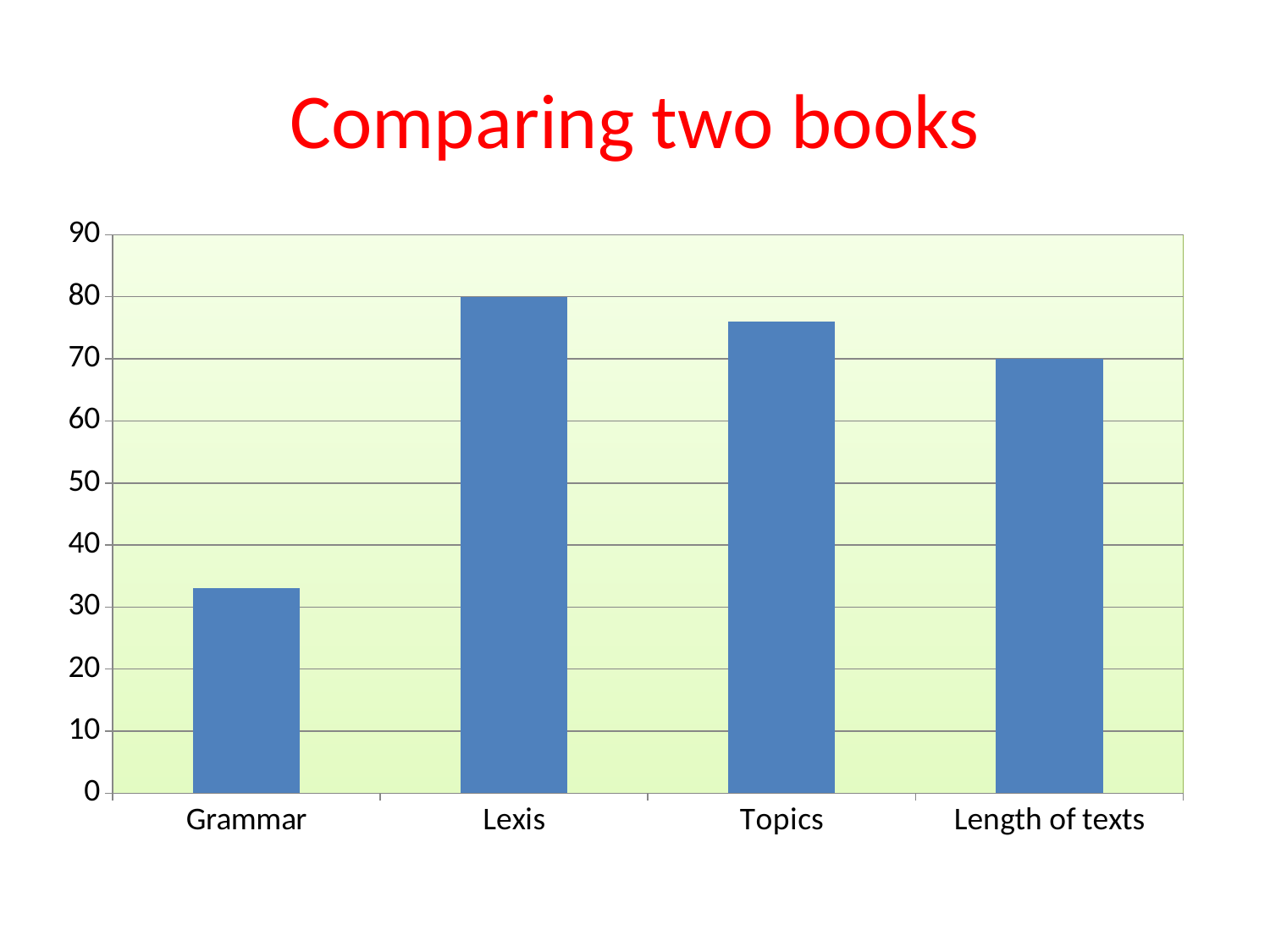
Is the value for Grammar greater or less than 40? less What is the value for Lexis in the chart? 80 Which category has the lowest bar in the chart? Grammar How many categories are shown on the x axis of the chart? 4 What is the value for Length of texts in the chart? 70 What kind of chart is shown on the slide? bar chart What is the highest value shown on the vertical axis of the chart? 90 Which is larger, the value for Topics or the value for Grammar? Topics Which category has the highest bar in the chart? Lexis Which is larger, the value for Lexis or the value for Topics? Lexis What is the difference between the values for Lexis and Length of texts? 10 Is the value for Topics greater or less than 70? greater